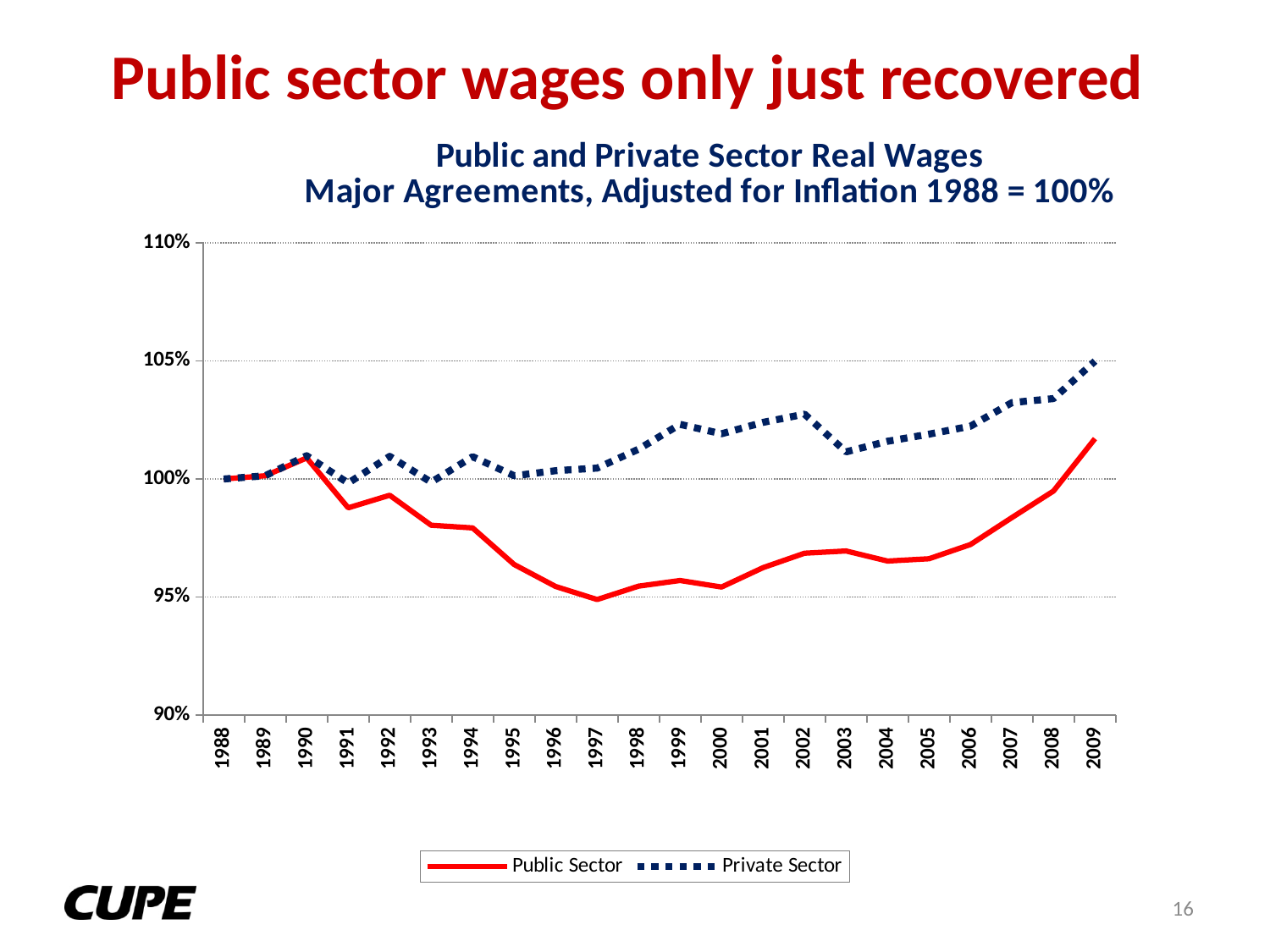
Is the Public Sector value in 2000 greater or less than 100%? less In which year is the Private Sector line at its highest? 2009 How many series does the legend list? 2 Is the Private Sector value in 2002 greater or less than 100%? greater What is the Public Sector value in 1988? 100% In which year is the Public Sector line at its lowest? 1997 Does the Public Sector line rise or fall from 1997 to 2009? rise What is the Private Sector value in 1988? 100% Is the Private Sector value in 2008 greater or less than 105%? less What kind of chart is shown on the slide? line chart In 2009, which series has the higher value, Public Sector or Private Sector? Private Sector How many years are plotted along the x axis? 22